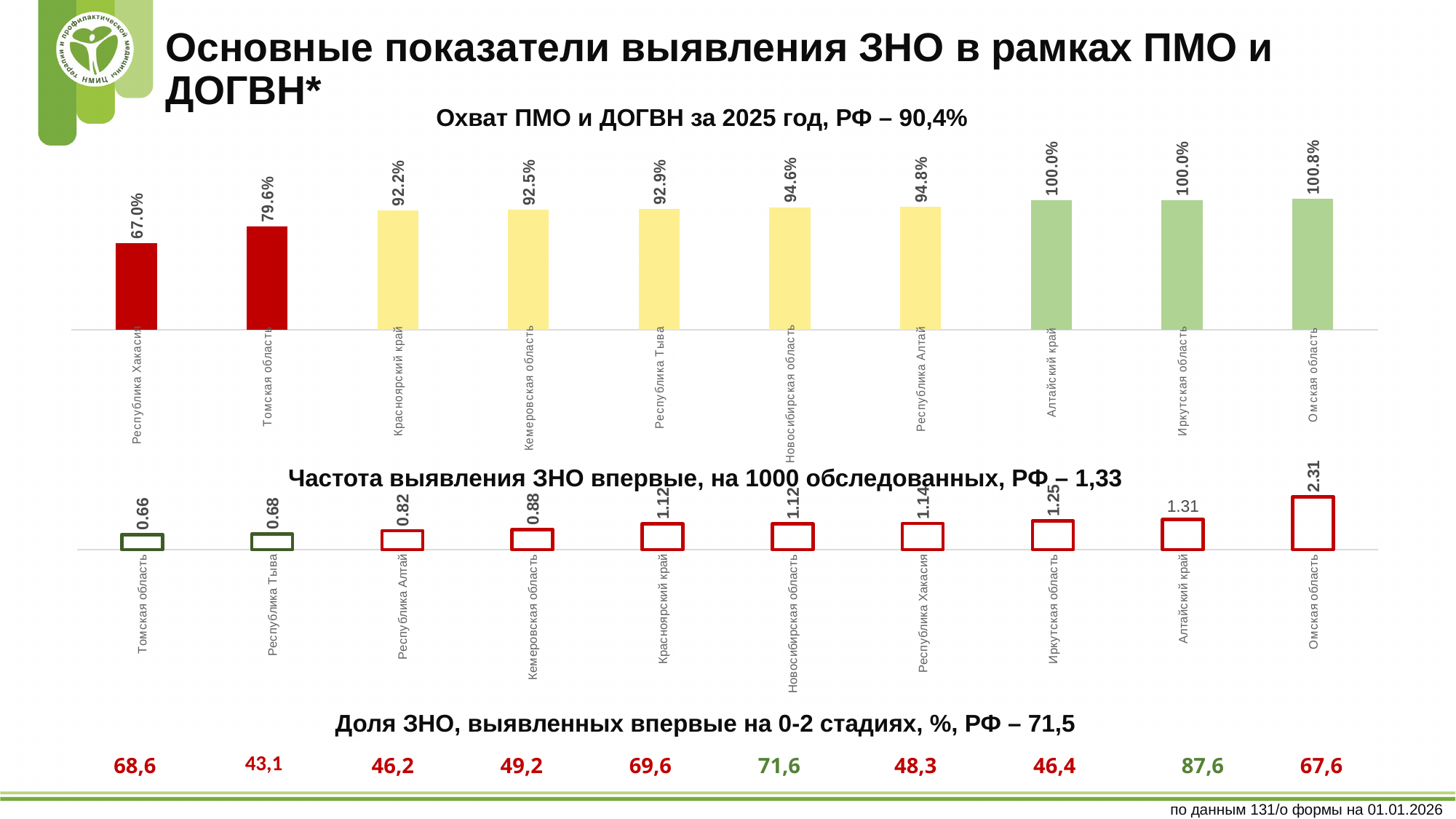
In the chart 'Частота выявления ЗНО впервые, на 1000 обследованных', what is the difference between Омская область and Алтайский край? 1.00 In the chart 'Охват ПМО и ДОГВН за 2025 год', how many regions are shown? 10 In the chart 'Охват ПМО и ДОГВН за 2025 год', what is the value for Новосибирская область? 94.6% In the chart 'Охват ПМО и ДОГВН за 2025 год', which region has the highest value? Омская область In the chart 'Частота выявления ЗНО впервые, на 1000 обследованных', which is larger: Республика Хакасия or Кемеровская область? Республика Хакасия What type of chart is 'Охват ПМО и ДОГВН за 2025 год'? Bar chart In the chart 'Охват ПМО и ДОГВН за 2025 год', which region has the lowest value? Республика Хакасия In the chart 'Частота выявления ЗНО впервые, на 1000 обследованных', which region has the lowest value? Томская область In the chart 'Охват ПМО и ДОГВН за 2025 год', what is the difference between Республика Алтай and Республика Хакасия? 27.8% In the chart 'Частота выявления ЗНО впервые, на 1000 обследованных', which region has the highest value? Омская область In the chart 'Частота выявления ЗНО впервые, на 1000 обследованных', what is the value for Иркутская область? 1.25 In the chart 'Охват ПМО и ДОГВН за 2025 год', what is the value for Томская область? 79.6%